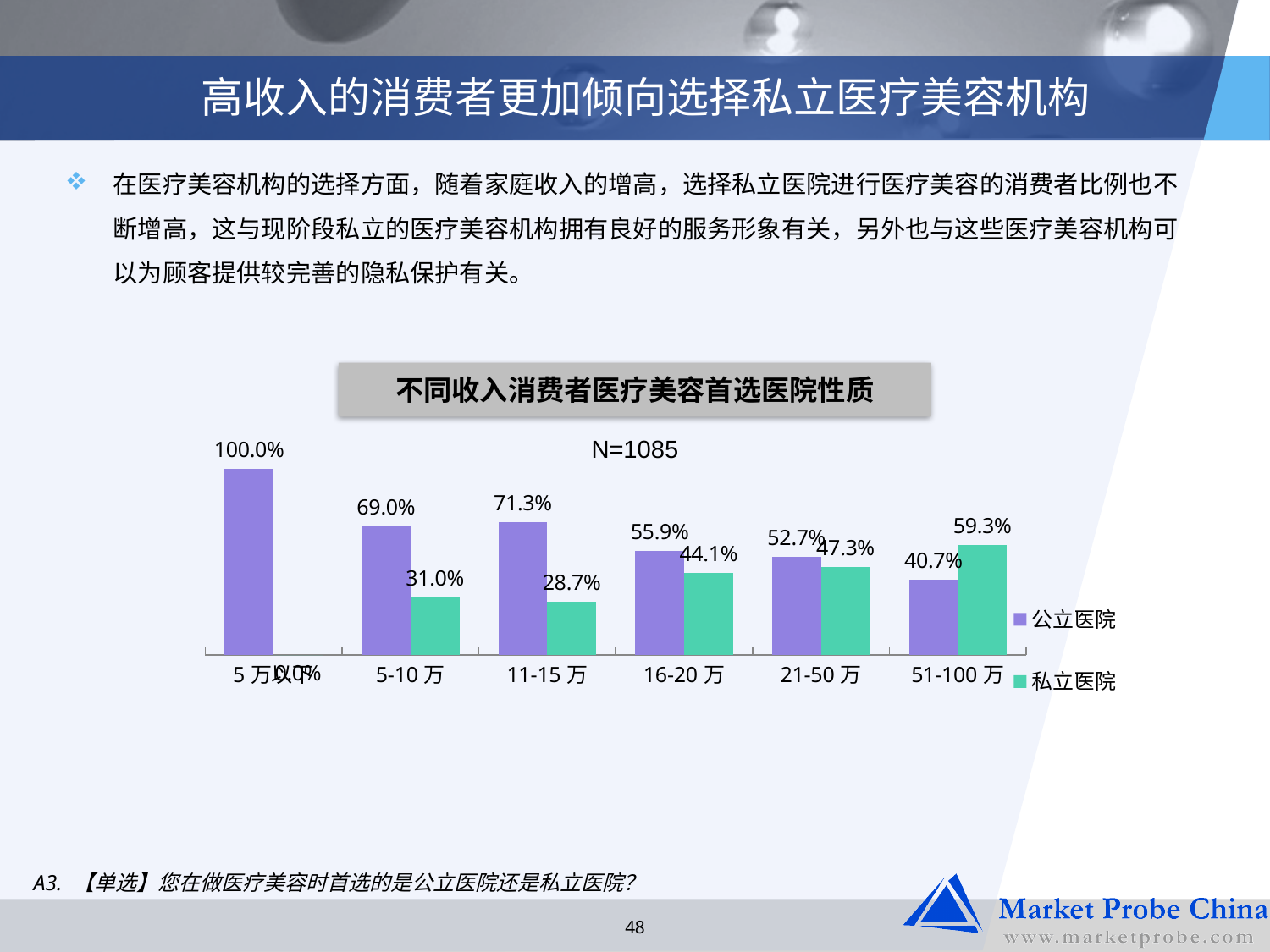
In the 51-100 万 income group, which is larger, 公立医院 or 私立医院? 私立医院 What is the value for 公立医院 in the 21-50 万 income group? 52.7% How many series does the legend list? 2 How many income groups are shown on the x axis? 6 What is the difference between 公立医院 and 私立医院 in the 16-20 万 income group? 11.8% What is the value for 公立医院 in the 5-10 万 income group? 69.0% What is the value for 私立医院 in the 11-15 万 income group? 28.7% What sample size (N) is shown on the chart? N=1085 Which income group has the highest value for 私立医院? 51-100 万 Which income group has the lowest value for 公立医院? 51-100 万 What is the value for 私立医院 in the 51-100 万 income group? 59.3% What kind of chart is shown on the slide? bar chart